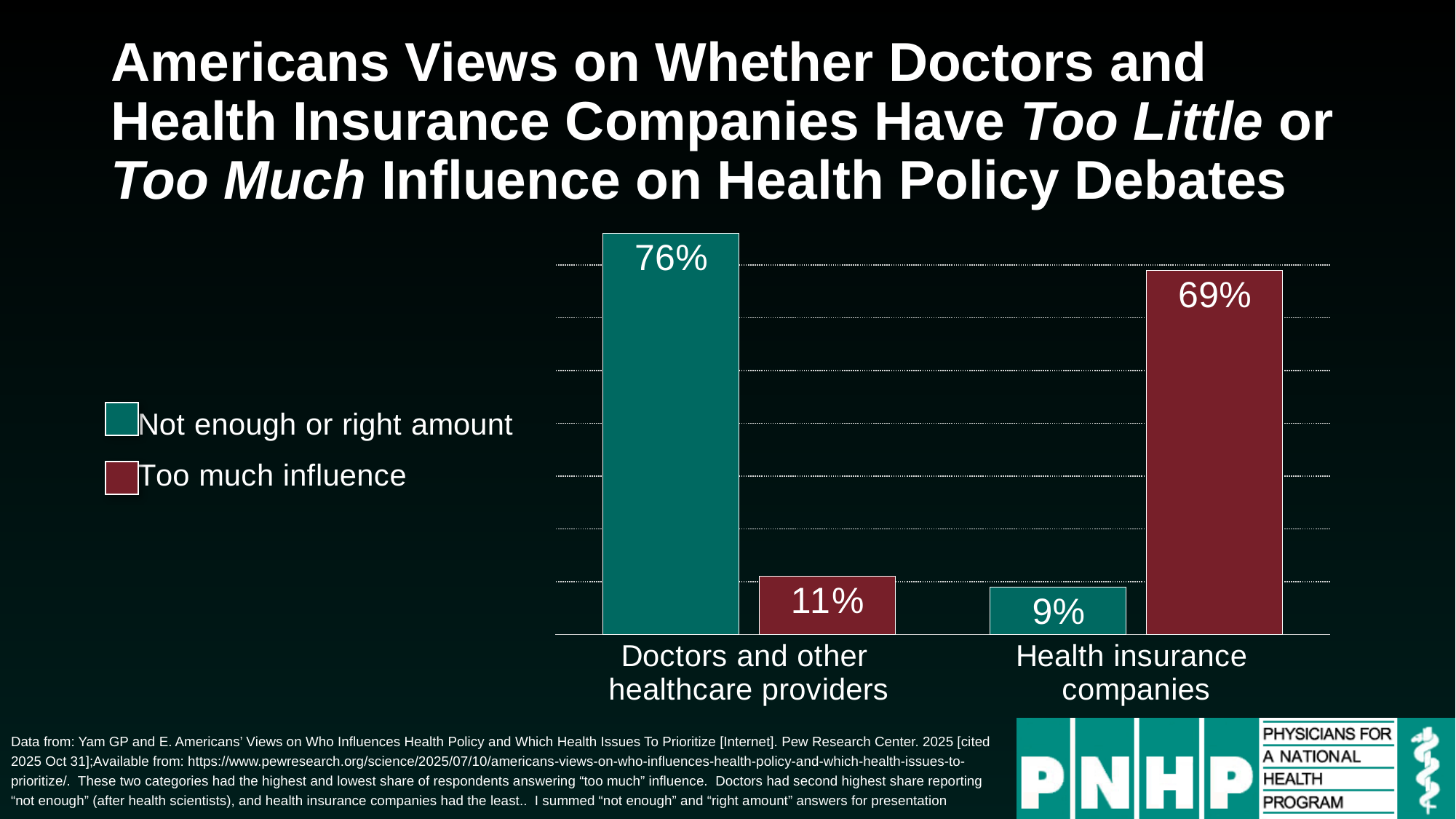
What is the difference between the 'Not enough or right amount' value for doctors and the 'Too much influence' value for doctors? 65 percentage points Which is larger: the 'Too much influence' value for doctors or for health insurance companies? Health insurance companies Which bar in the chart has the lowest value? Not enough or right amount for health insurance companies (9%) How many categories are shown on the x axis of the chart? 2 What percentage of Americans say doctors and other healthcare providers have not enough or the right amount of influence? 76% How many series does the legend list? 2 What type of chart is shown on the slide? Bar chart What is the difference between the 'Too much influence' values for health insurance companies and for doctors and other healthcare providers? 58 percentage points What percentage of Americans say health insurance companies have too much influence? 69% Which bar in the chart has the highest value? Not enough or right amount for doctors and other healthcare providers (76%) What is the value for 'Not enough or right amount' for health insurance companies? 9% What is the value for 'Too much influence' for doctors and other healthcare providers? 11%